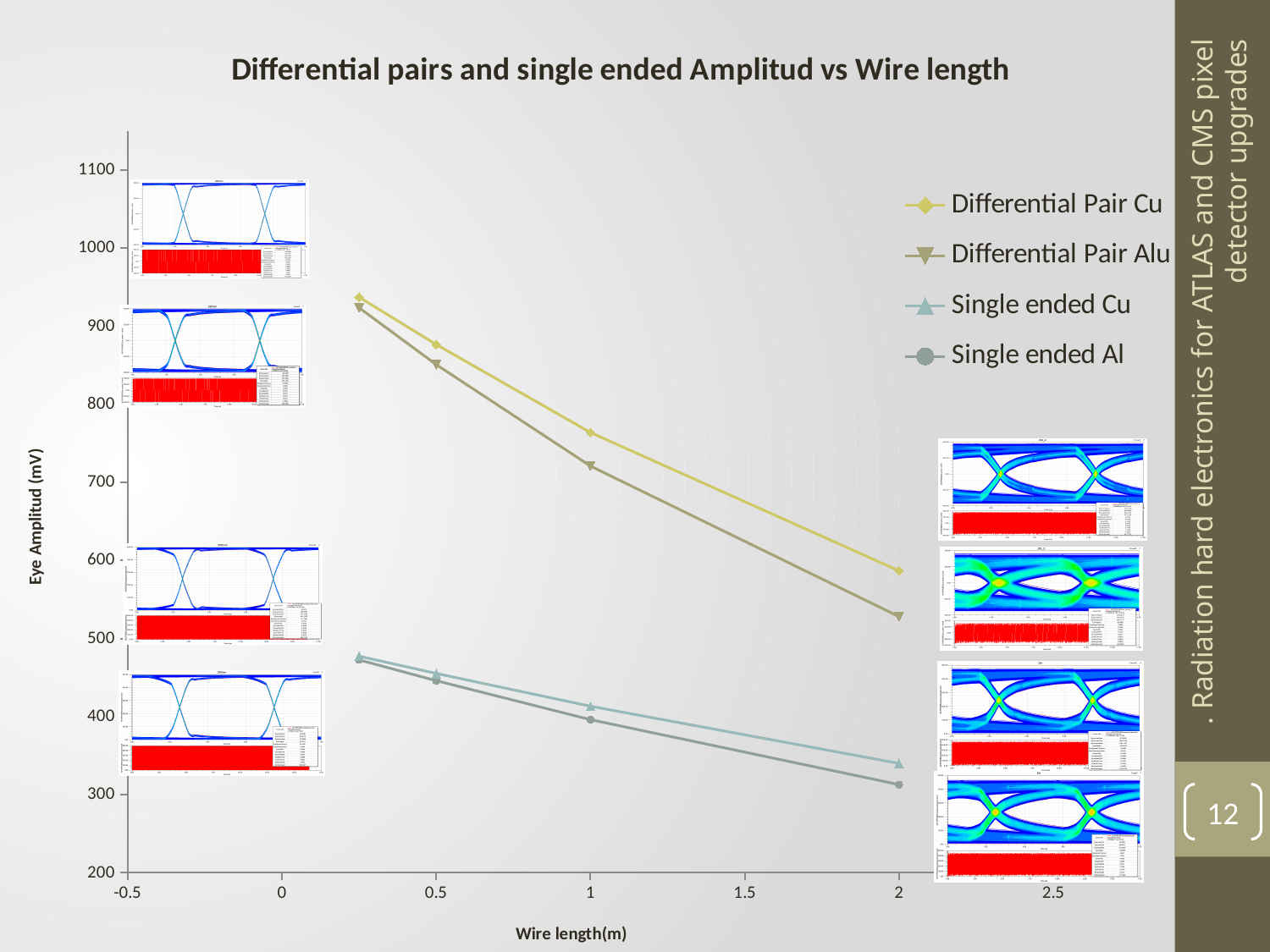
Is the value for Single ended Cu at a wire length of 2 m greater or less than 400? less Is the value for Differential Pair Cu at a wire length of 1 m greater or less than 700? greater What kind of chart is shown on the slide? line chart What is the title of the chart? Differential pairs and single ended Amplitud vs Wire length How many data points are plotted for the Differential Pair Cu series? 4 Is the value for Differential Pair Cu at a wire length of 0.5 m greater or less than 800? greater What is the label of the y axis? Eye Amplitud (mV) Which series has the lowest value at a wire length of 2 m? Single ended Al At a wire length of 2 m, which is larger: Differential Pair Cu or Differential Pair Alu? Differential Pair Cu How many series does the legend list? 4 Do the values for Differential Pair Alu rise or fall as wire length increases? fall